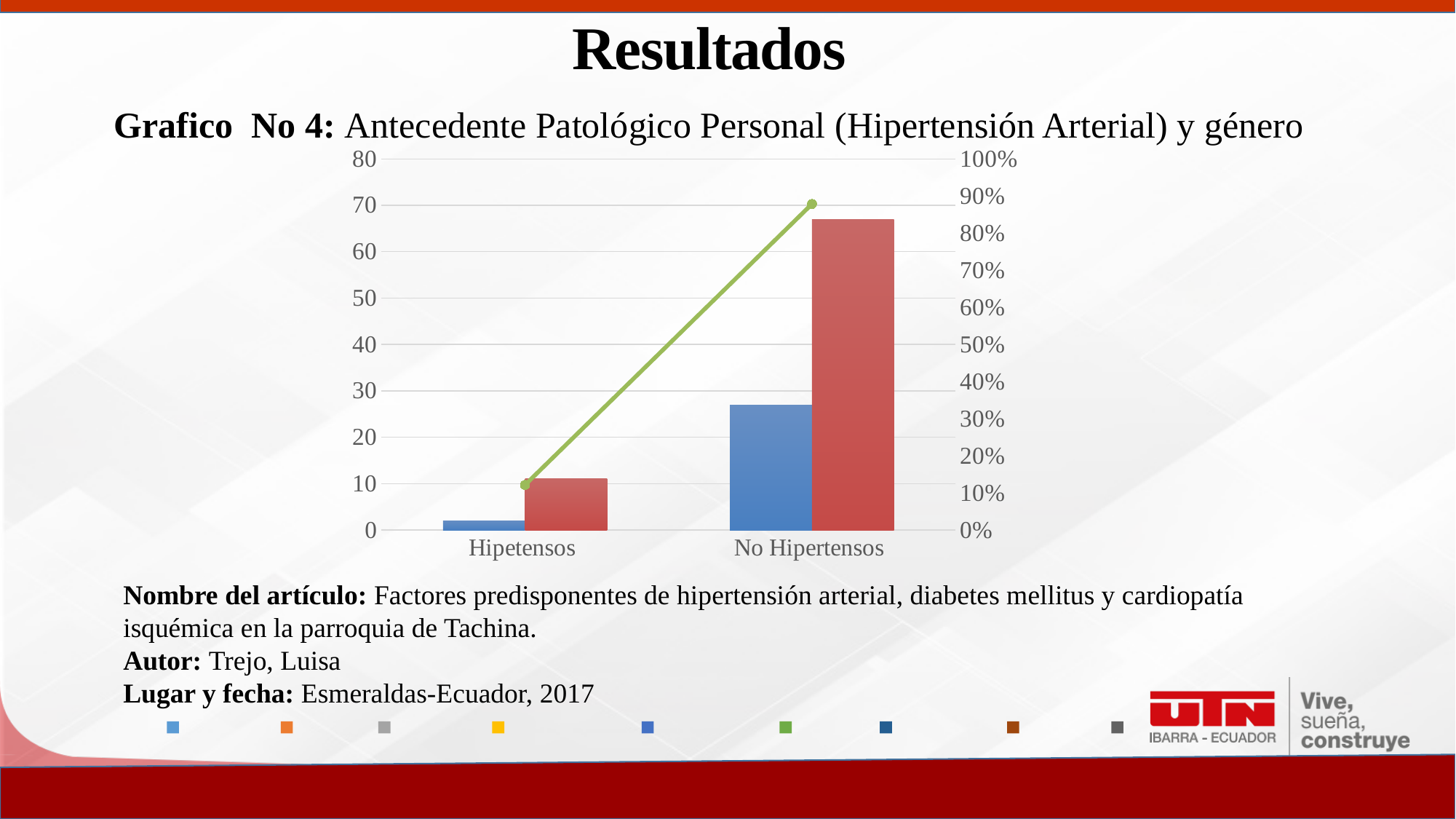
Is the value of the blue bar for No Hipertensos greater or less than 20 on the left axis? greater How many categories are shown on the x axis of the chart? 2 Which category has the highest blue bar? No Hipertensos Which category has the taller red bar, Hipetensos or No Hipertensos? No Hipertensos What kind of chart is shown on the slide? bar chart with a line What is the highest tick value shown on the left vertical axis of the chart? 80 Is the value of the red bar for Hipetensos greater or less than 20 on the left axis? less Is the value of the red bar for No Hipertensos greater or less than 60 on the left axis? greater Does the green line rise or fall from Hipetensos to No Hipertensos? rises